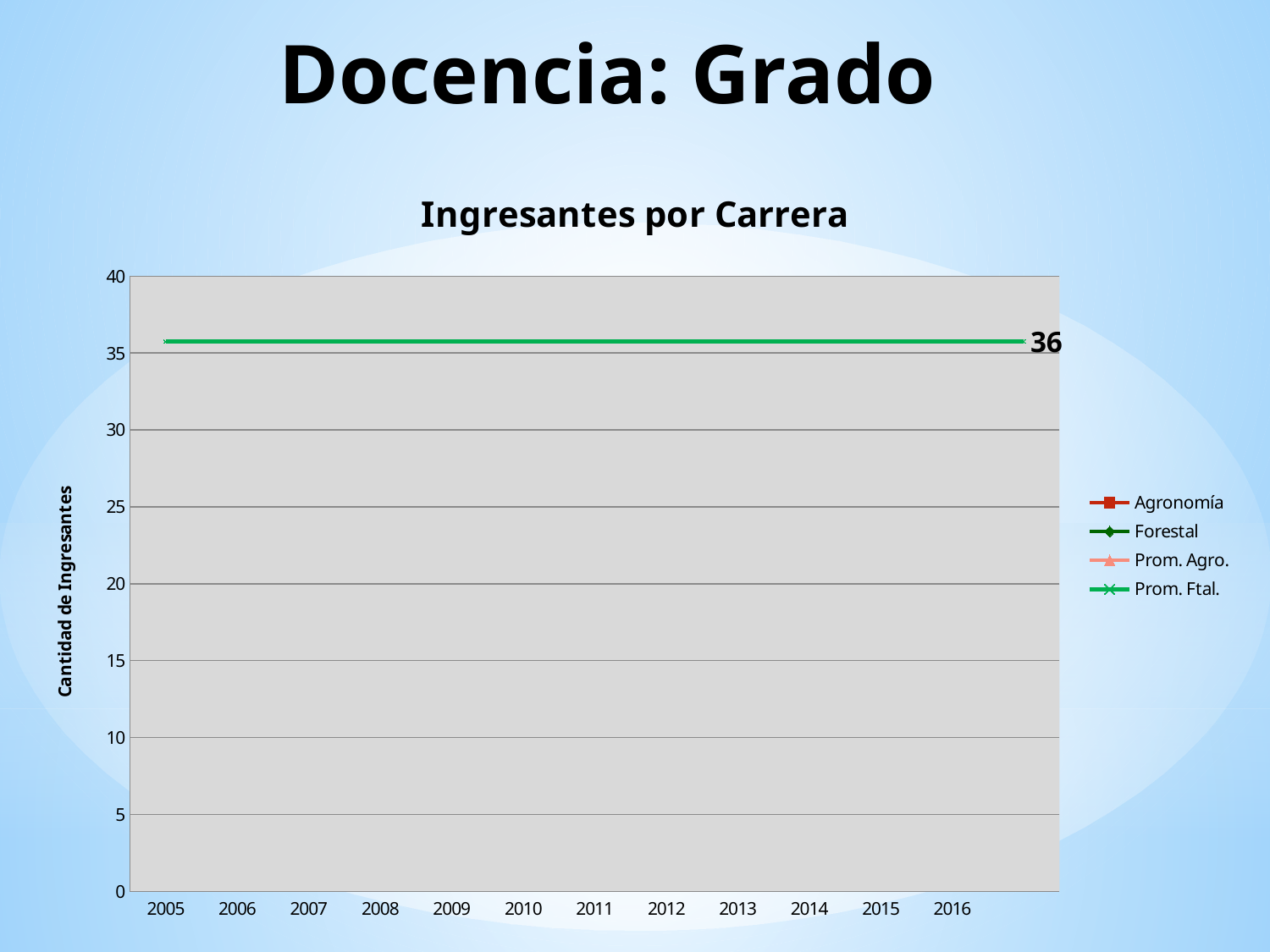
What kind of chart is shown on the slide? line chart What value is printed as the data label at the end of the plotted line? 36 What is the first year shown on the x axis? 2005 What is the title of the chart? Ingresantes por Carrera Is the value of the plotted line greater or less than 40? less What is the label of the vertical axis? Cantidad de Ingresantes What is the maximum value shown on the vertical axis? 40 Does the plotted line rise, fall, or stay flat from 2005 to 2016? stays flat How many series does the legend of the 'Ingresantes por Carrera' chart list? 4 How many years are shown along the x axis of the chart? 12 What is the last year shown on the x axis? 2016 Is the value of the plotted line greater or less than 30? greater